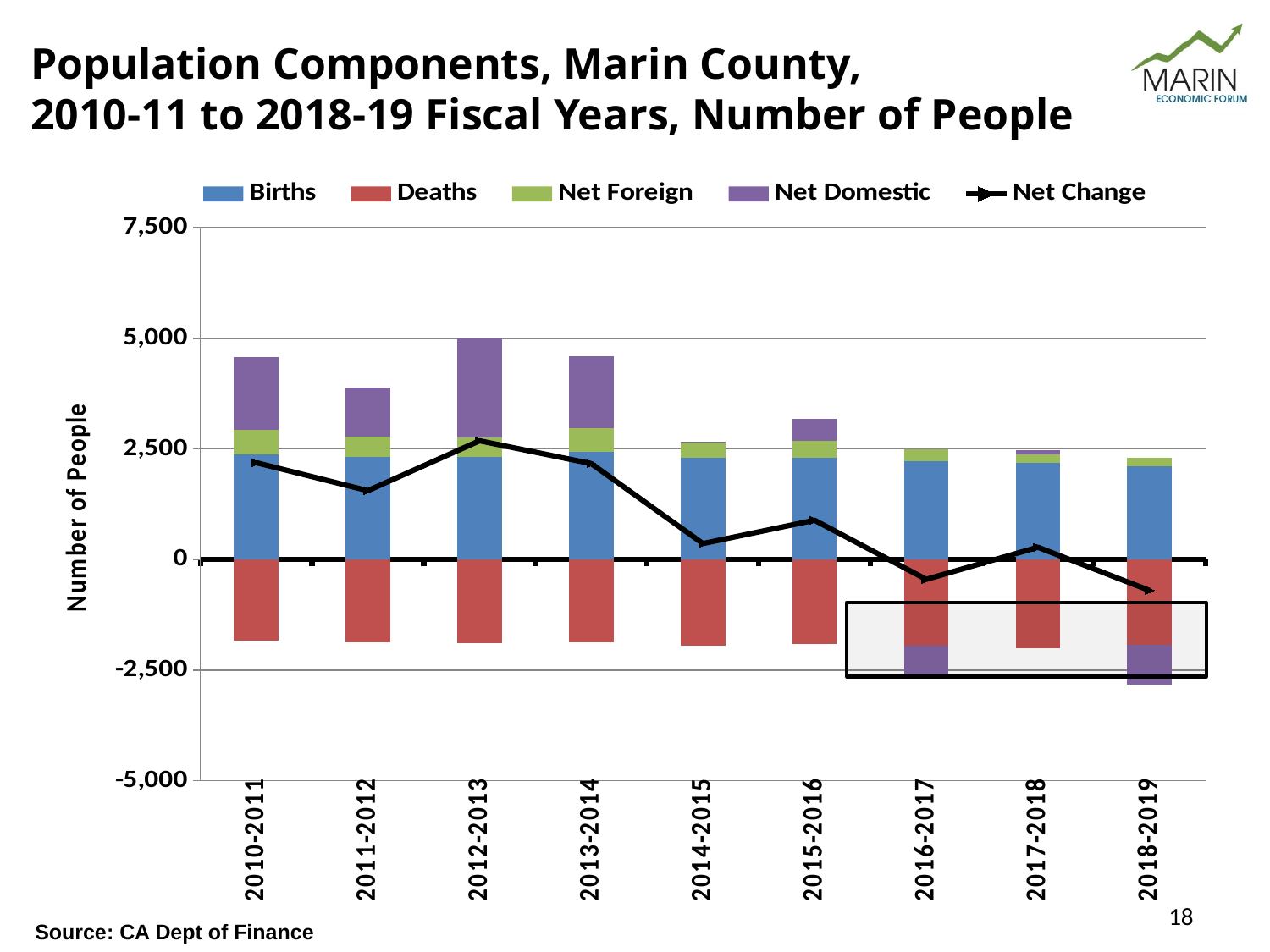
In which fiscal year is the Net Change line at its highest? 2012-2013 Is the Births value for 2010-2011 greater or less than 2,500? less How many fiscal years are shown on the x axis? 9 Does the Net Change line generally rise or fall from 2010-2011 to 2018-2019? fall How many series does the legend list? 5 Which fiscal year has the larger Net Change, 2010-2011 or 2011-2012? 2010-2011 Which series is plotted as a line rather than bars? Net Change Is the Net Change value for 2016-2017 greater or less than 0? less Is the Net Domestic value for 2018-2019 greater or less than 0? less What is the title of the vertical axis? Number of People What kind of chart is shown on the slide? A stacked bar chart with a line